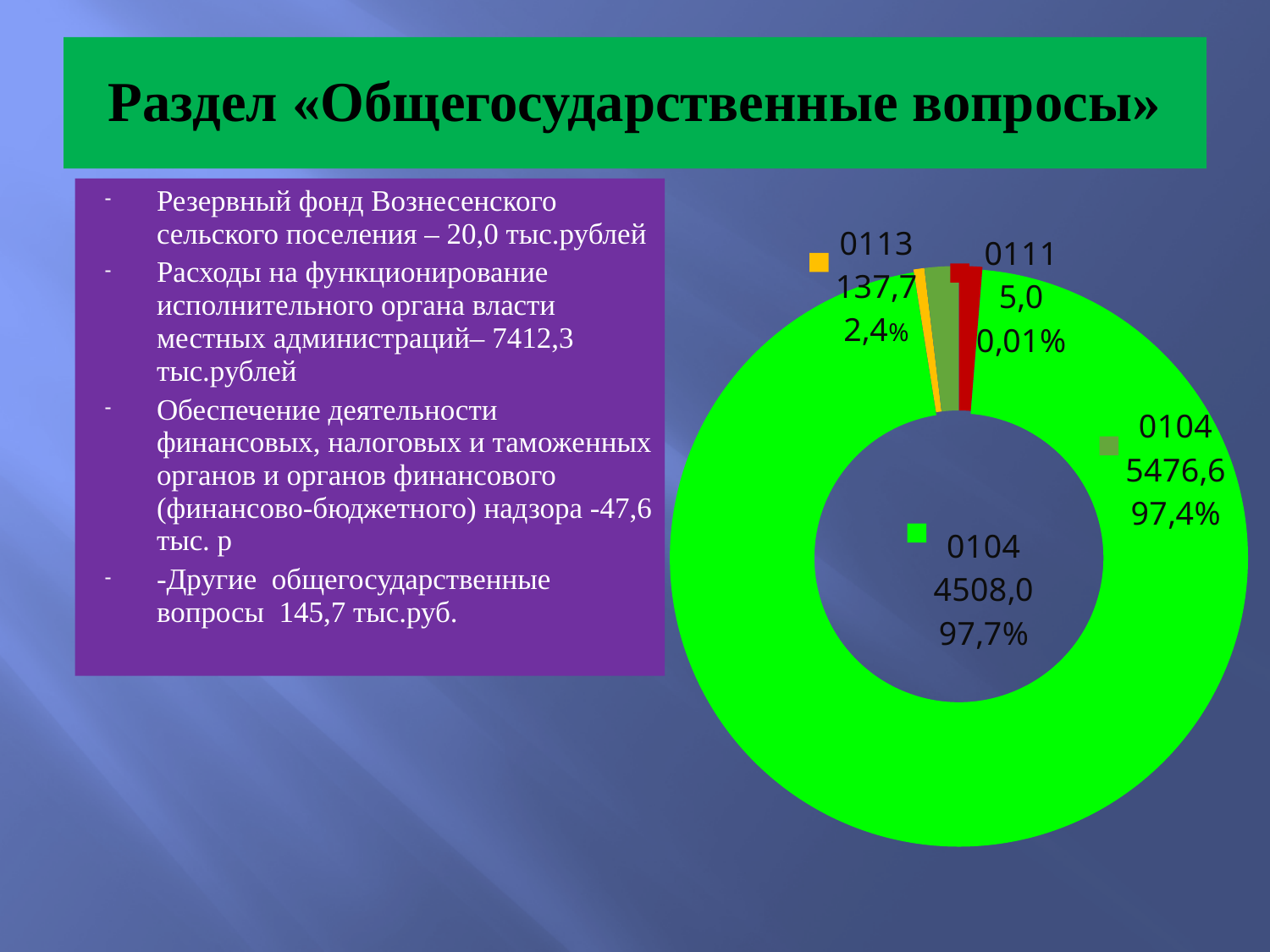
What value is shown for the large green slice labelled 0104? 4508,0 What value is shown for the slice labelled 0113? 137,7 What is the difference between the values for 0113 and 0111? 132,7 What kind of chart is shown on the slide? doughnut chart What value is shown for the slice labelled 0111? 5,0 What is the title of the slide above the chart? Раздел «Общегосударственные вопросы» How many data labels are shown on the chart? 4 What percentage is shown next to the value 5476,6? 97,4% What percentage is shown for the slice labelled 0113? 2,4% What percentage is shown for the slice labelled 0111? 0,01% Which slice is larger, 0113 or 0111? 0113